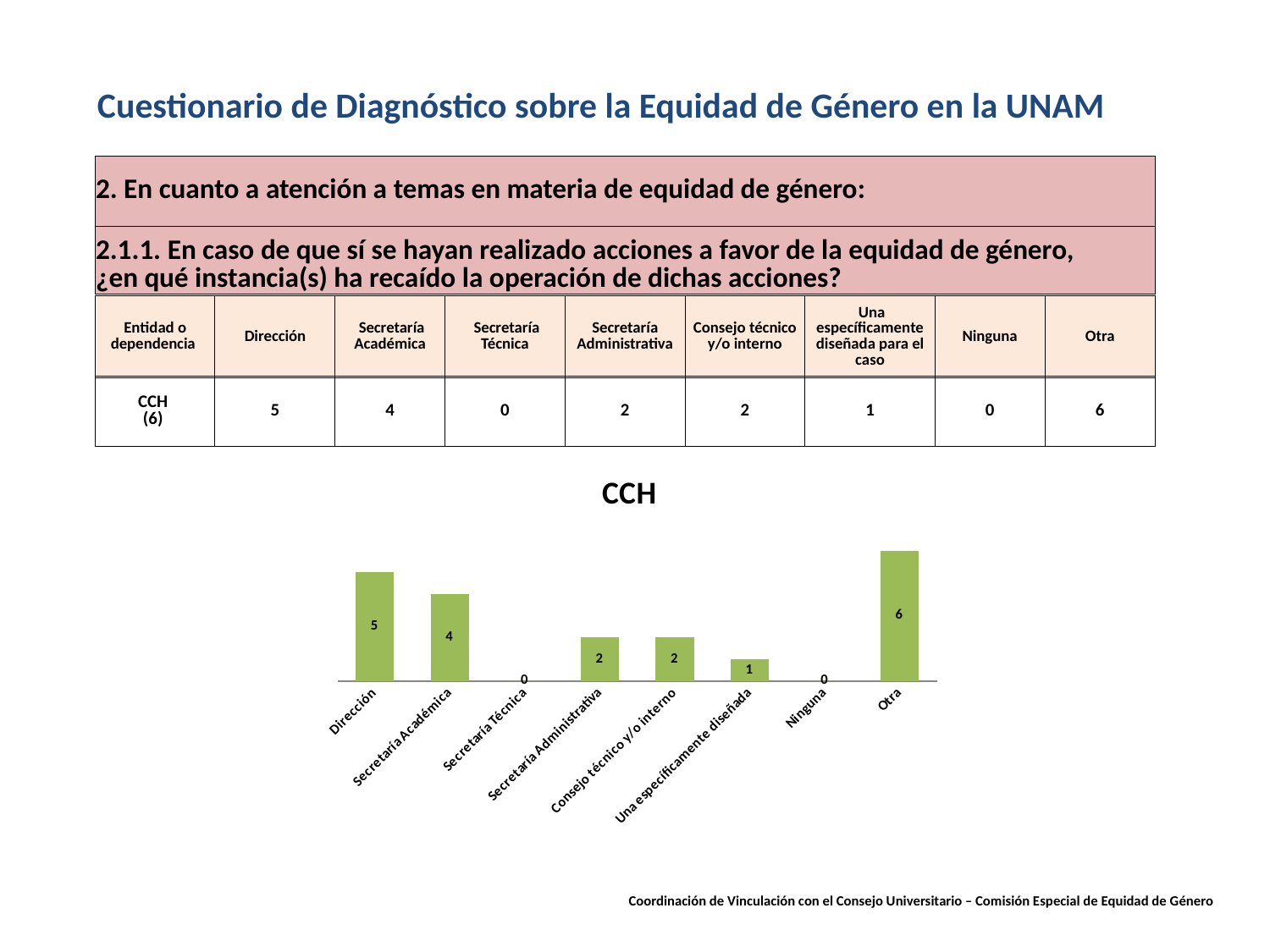
What is the value for Una específicamente diseñada in the CCH chart? 1 What is the difference between the values for Dirección and Secretaría Administrativa in the CCH chart? 3 Which categories have a value of 0 in the CCH chart? Secretaría Técnica and Ninguna What is the value for Otra in the CCH chart? 6 What is the value for Dirección in the CCH chart? 5 Which category has the highest value in the CCH chart? Otra How many categories are shown on the x axis of the CCH chart? 8 What is the value for Secretaría Académica in the CCH chart? 4 What is the title of the chart on the slide? CCH What is the difference between the values for Otra and Dirección in the CCH chart? 1 Which is larger in the CCH chart, Secretaría Académica or Consejo técnico y/o interno? Secretaría Académica What kind of chart is the CCH chart? Bar chart